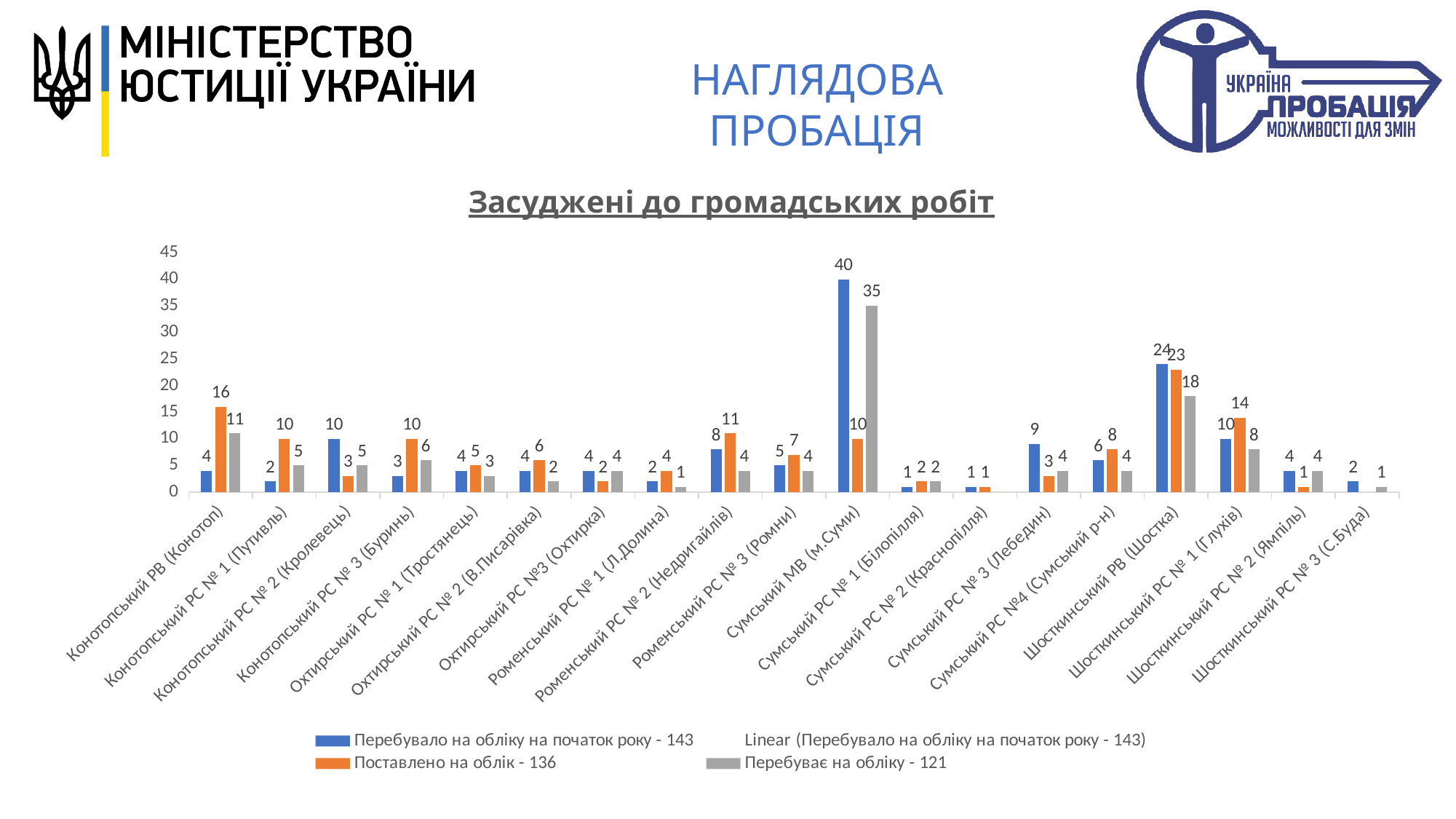
What is the value of 'Перебувало на обліку на початок року - 143' for Шосткинський РВ (Шостка)? 24 What is the value of 'Поставлено на облік - 136' for Конотопський РВ (Конотоп)? 16 What type of chart is shown on the slide? bar chart How many entries does the chart legend list? 4 For Шосткинський РС № 1 (Глухів), which is larger: 'Поставлено на облік - 136' or 'Перебуває на обліку - 121'? Поставлено на облік - 136 What is the difference between 'Перебувало на обліку на початок року - 143' and 'Поставлено на облік - 136' for Сумський МВ (м.Суми)? 30 What is the value of 'Перебуває на обліку - 121' for Конотопський РС № 3 (Буринь)? 6 How many categories are shown on the x axis of the chart? 19 Is the value of 'Перебувало на обліку на початок року - 143' for Сумський МВ (м.Суми) greater or less than 30? greater What is the value of 'Перебуває на обліку - 121' for Сумський МВ (м.Суми)? 35 What is the title of the chart? Засуджені до громадських робіт Which category has the highest value for 'Перебувало на обліку на початок року - 143'? Сумський МВ (м.Суми)